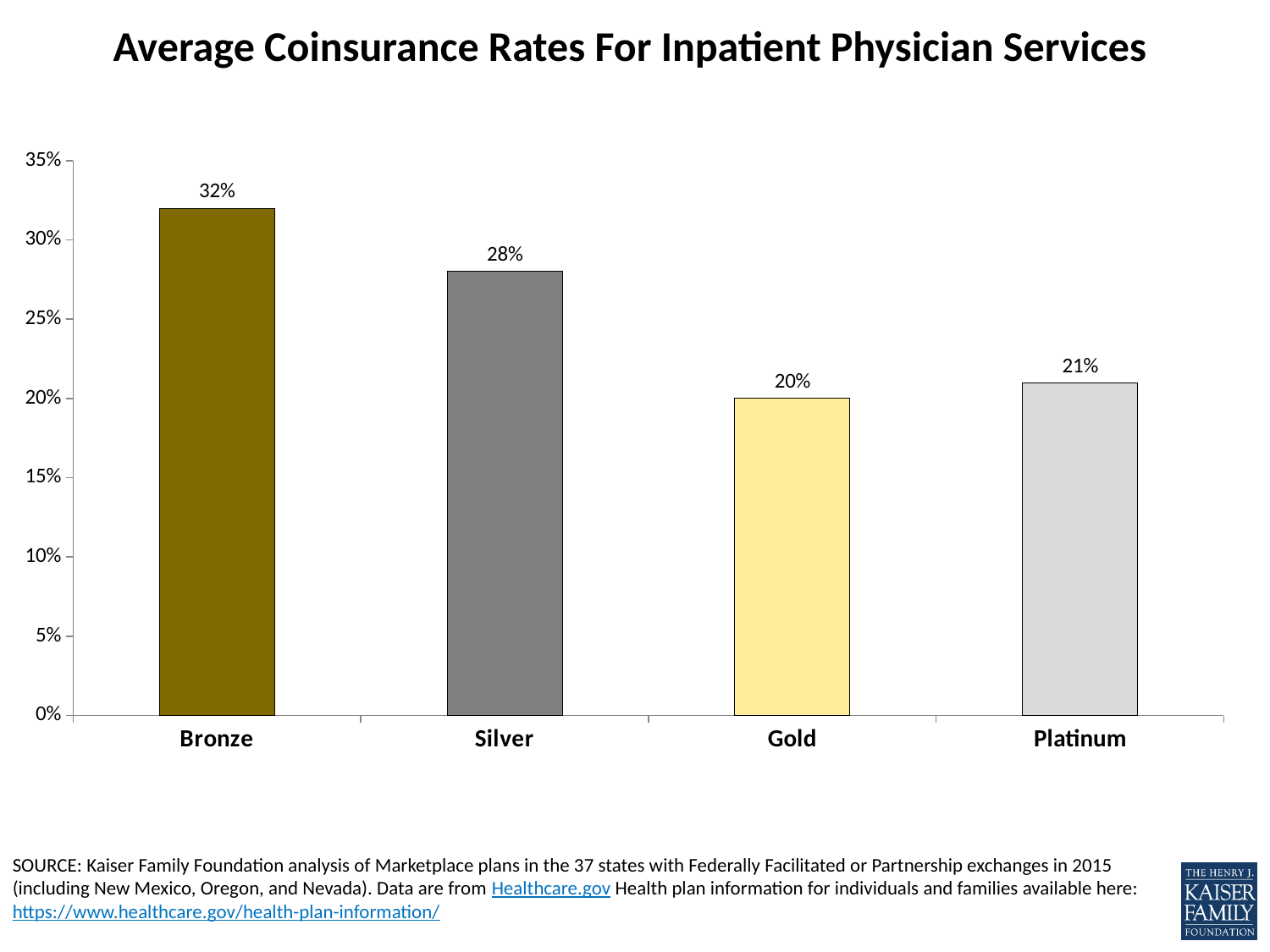
Which has a higher average coinsurance rate, Silver or Platinum? Silver What is the average coinsurance rate for Bronze plans? 32% What is the average coinsurance rate for Silver plans? 28% What is the title of the chart? Average Coinsurance Rates For Inpatient Physician Services Which plan tier has the lowest average coinsurance rate? Gold How many plan tiers are shown in the chart? 4 Which plan tier has the highest average coinsurance rate? Bronze What is the difference between the Bronze and Gold average coinsurance rates? 12 percentage points What is the difference between the Bronze and Silver average coinsurance rates? 4 percentage points What is the average coinsurance rate for Gold plans? 20% What type of chart is shown on the slide? Bar chart What is the average coinsurance rate for Platinum plans? 21%